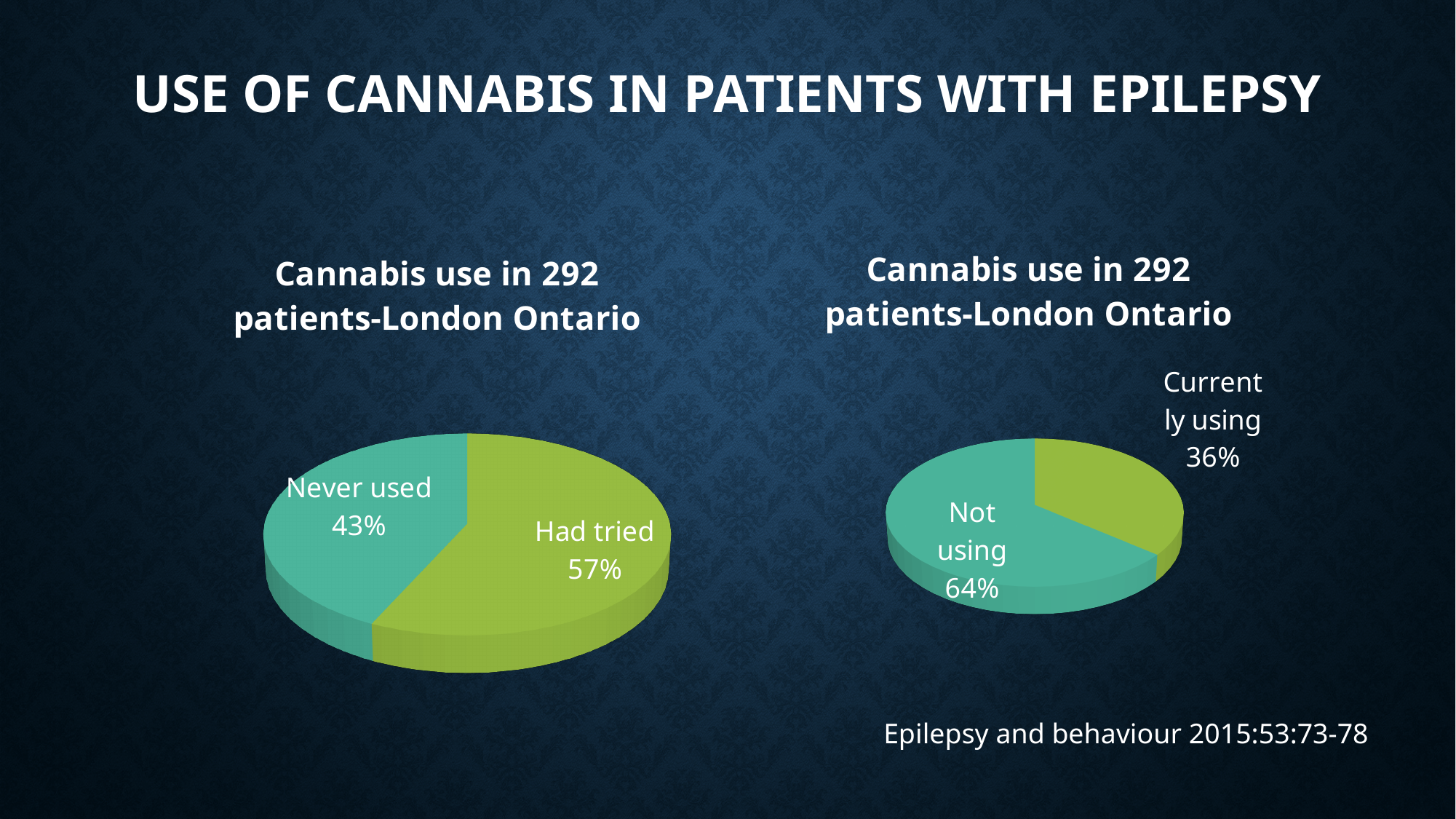
In the right pie chart, which is larger: Not using or Currently using? Not using In the left pie chart, what is the difference between the Had tried and Never used percentages? 14% In the left pie chart, which slice is the largest? Had tried How many slices does the left pie chart have? 2 What is the title of the right chart? Cannabis use in 292 patients-London Ontario In the right pie chart, what is the difference between the Not using and Currently using percentages? 28% In the left pie chart, what percentage of patients had tried cannabis? 57% What type of chart is used on the left of the slide? Pie chart In the right pie chart, what percentage of patients are currently using cannabis? 36% In the right pie chart, which slice is the smallest? Currently using In the left pie chart, what percentage of patients never used cannabis? 43% In the right pie chart, what percentage of patients are not using cannabis? 64%